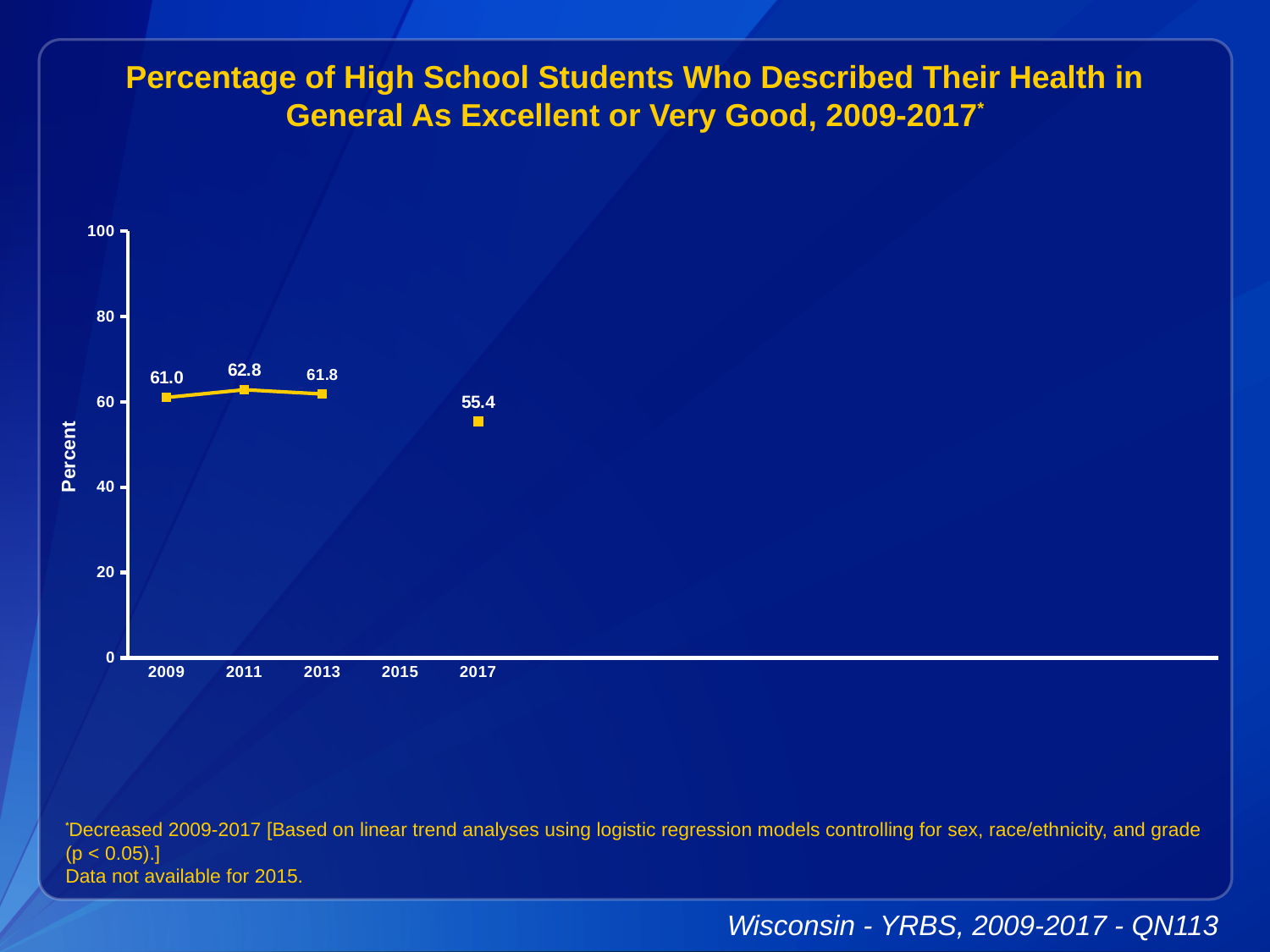
What kind of chart is shown on the slide? line chart What is the label on the y axis? Percent What is the value plotted for 2011? 62.8 Which year has the highest value? 2011 What is the difference between the 2011 value and the 2017 value? 7.4 Is the value for 2017 greater or less than 60? less What is the value plotted for 2013? 61.8 How many years are labeled on the x axis? 5 Which is larger, the value for 2009 or the value for 2013? 2013 What is the value plotted for 2017? 55.4 What percentage of high school students described their health as excellent or very good in 2009? 61.0 Which year has the lowest value? 2017